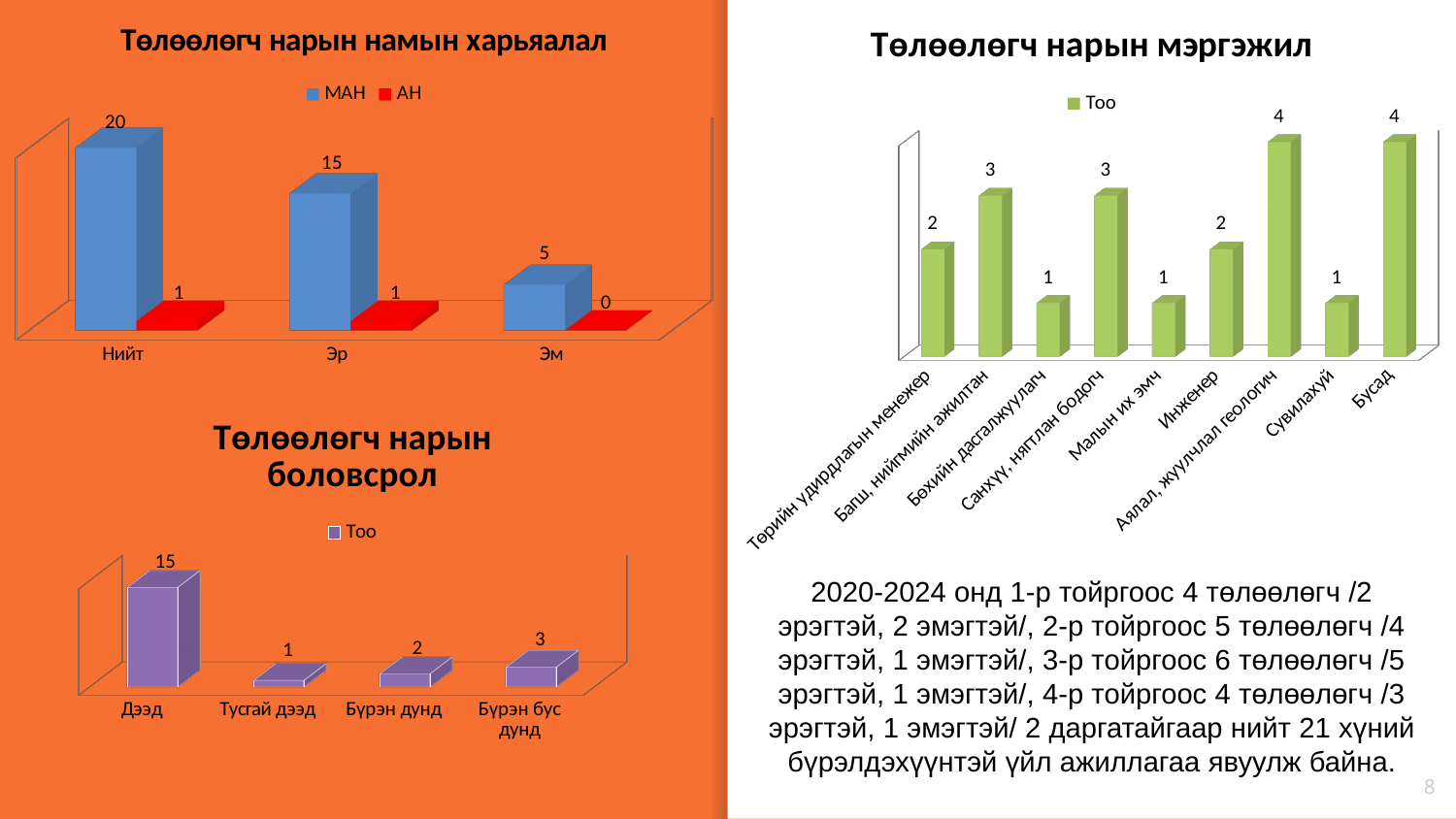
In the chart titled "Төлөөлөгч нарын мэргэжил", what is the value for Инженер? 2 In the chart titled "Төлөөлөгч нарын намын харьяалал", what is the АН value for Эм? 0 In the chart titled "Төлөөлөгч нарын боловсрол", which is larger, the value for Тусгай дээд or Бүрэн дунд? Бүрэн дунд In the chart titled "Төлөөлөгч нарын боловсрол", how many categories are shown? 4 In the chart titled "Төлөөлөгч нарын боловсрол", which category has the highest value? Дээд In the chart titled "Төлөөлөгч нарын намын харьяалал", what is the difference between the МАН values for Эр and Эм? 10 In the chart titled "Төлөөлөгч нарын намын харьяалал", how many series does the legend list? 2 What kind of chart is the one titled "Төлөөлөгч нарын мэргэжил"? Bar chart In the chart titled "Төлөөлөгч нарын боловсрол", what is the value for Бүрэн бус дунд? 3 In the chart titled "Төлөөлөгч нарын мэргэжил", what is the difference between the values for Бусад and Сувилахуй? 3 In the chart titled "Төлөөлөгч нарын намын харьяалал", what is the МАН value for Нийт? 20 In the chart titled "Төлөөлөгч нарын мэргэжил", how many categories are shown? 9